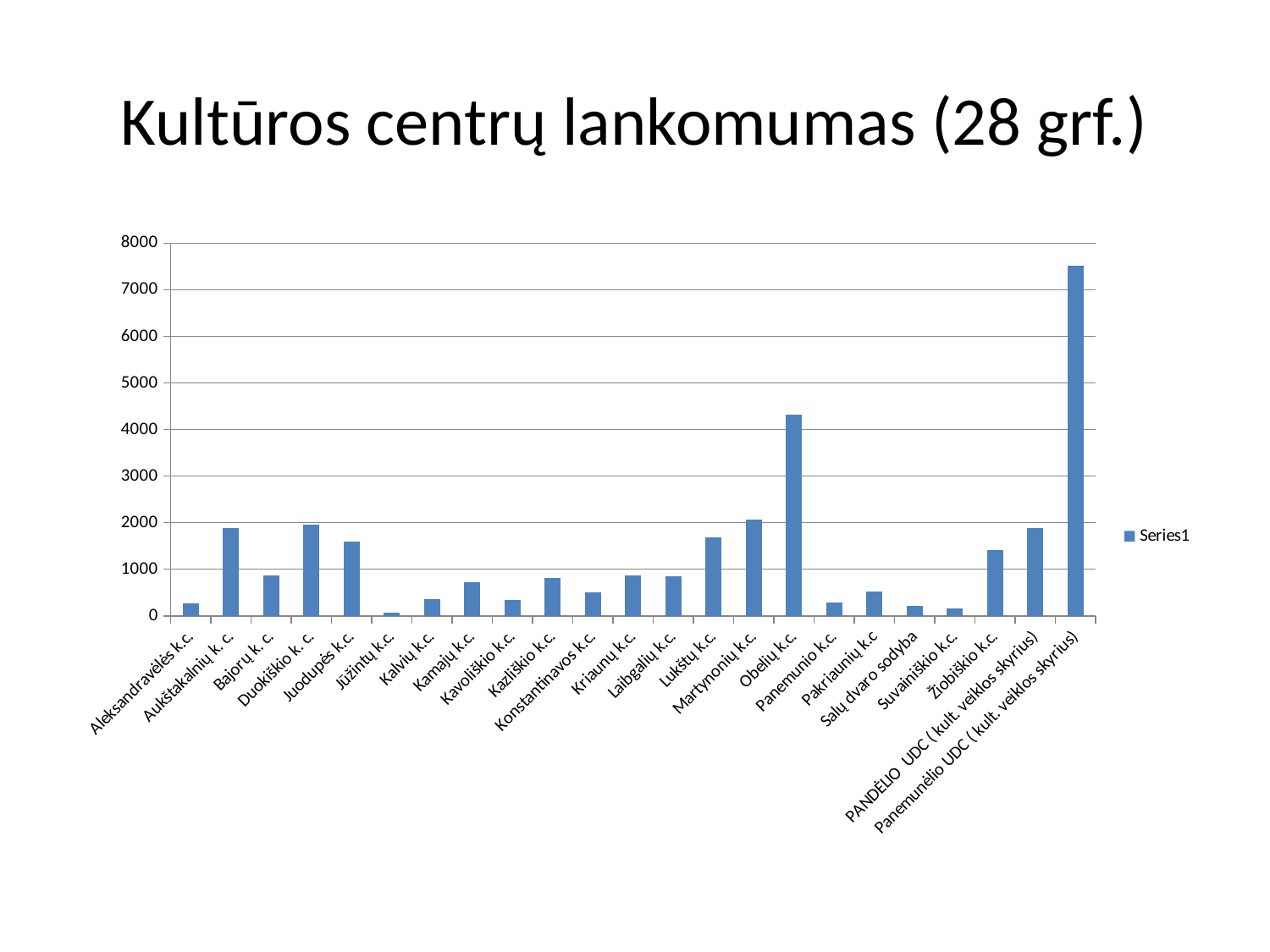
Is the value for Bajorų k. c. greater or less than 1000? less How many categories are shown on the x axis? 23 Which is larger, the value for Obelių k.c. or the value for Martynonių k.c.? Obelių k.c. Is the value for Obelių k.c. greater or less than 4000? greater How many series does the legend list? 1 What is the title of the slide? Kultūros centrų lankomumas (28 grf.) Is the value for Panemunėlio UDC (kult. veiklos skyrius) greater or less than 7000? greater What type of chart is shown on the slide? bar chart Which category has the highest value? Panemunėlio UDC (kult. veiklos skyrius) Which is larger, the value for Kazliškio k.c. or the value for Kavoliškio k.c.? Kazliškio k.c. Which category has the lowest value? Jūžintų k.c.